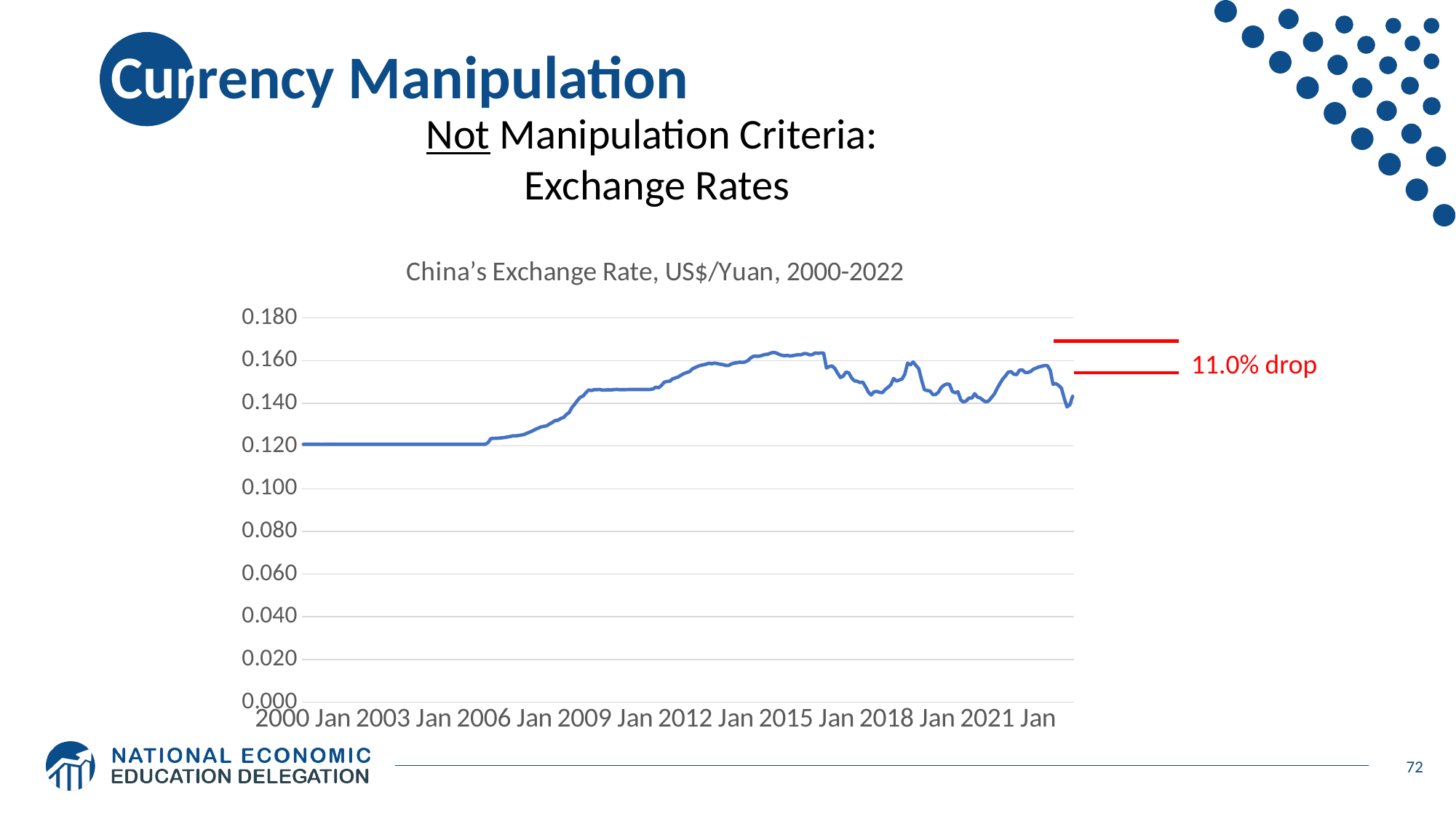
What percentage drop is annotated in red on the right side of the chart? 11.0% drop How many year labels are shown on the x axis? 8 Is the exchange rate at the end of the series (2022) greater or less than 0.160? less Is the exchange rate in 2000 Jan greater or less than 0.140? less Does the exchange rate rise or fall between 2006 Jan and 2012 Jan? rise Does the exchange rate rise or fall between 2015 Jan and 2018 Jan? fall What is the title of the chart? China's Exchange Rate, US$/Yuan, 2000-2022 What is the highest value shown on the y axis? 0.180 What kind of chart is shown on the slide? line chart Is the exchange rate in 2012 Jan greater or less than 0.140? greater